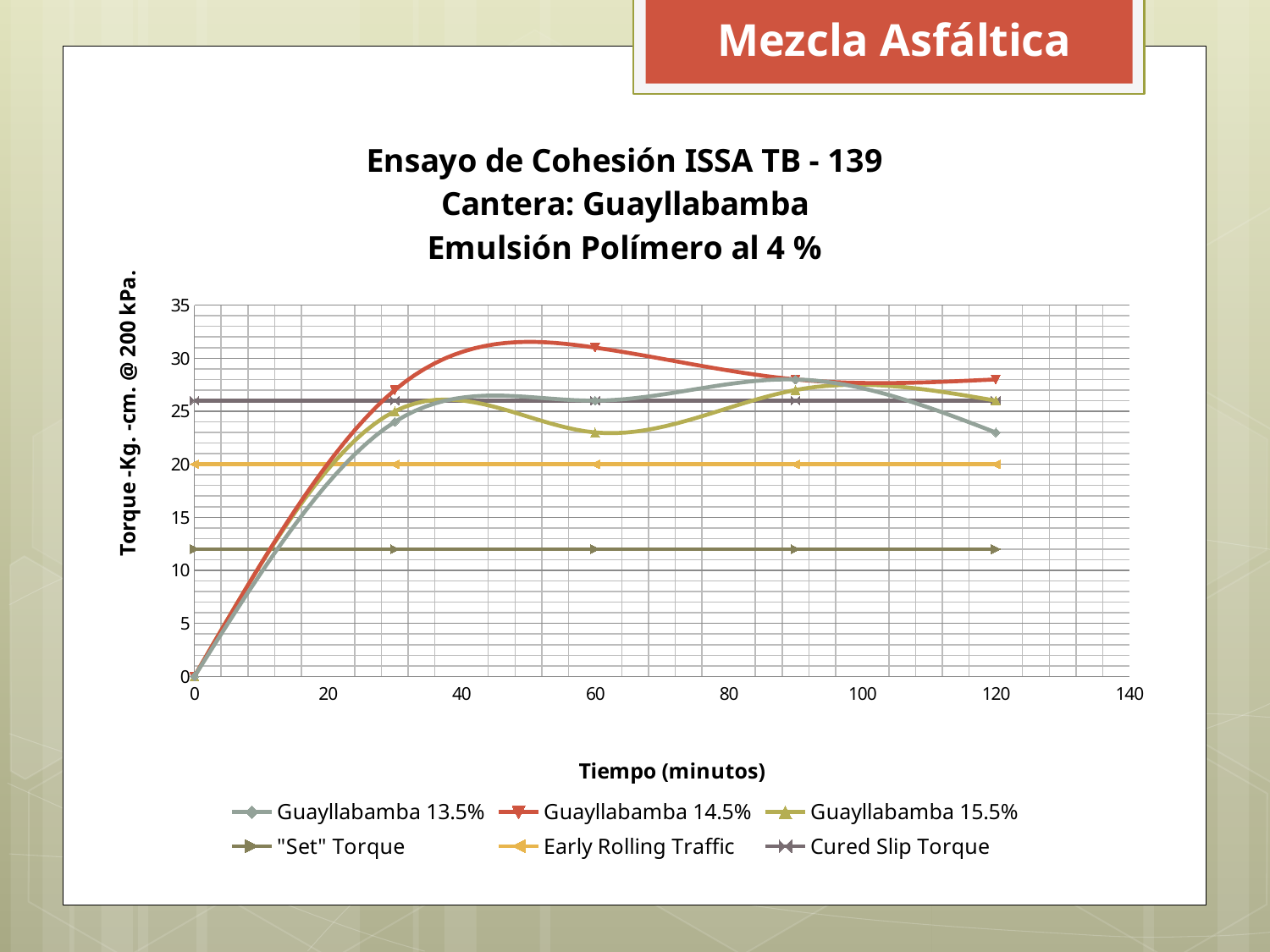
Is the value for Guayllabamba 15.5% at 60 minutes greater or less than 25? less At 60 minutes, which is larger: Guayllabamba 14.5% or Guayllabamba 15.5%? Guayllabamba 14.5% What kind of chart is shown on the slide? line chart How many series does the legend list? 6 What is the label of the x axis? Tiempo (minutos) What is the value of the Early Rolling Traffic line? 20 Does Guayllabamba 13.5% rise or fall between 0 and 30 minutes? rise Which of the horizontal reference lines has the lowest value? "Set" Torque Is the value for Guayllabamba 14.5% at 60 minutes greater or less than 25? greater Is the value of the "Set" Torque line greater or less than 15? less Which series reaches the highest torque value on the chart? Guayllabamba 14.5% What is the value of Guayllabamba 14.5% at 0 minutes? 0